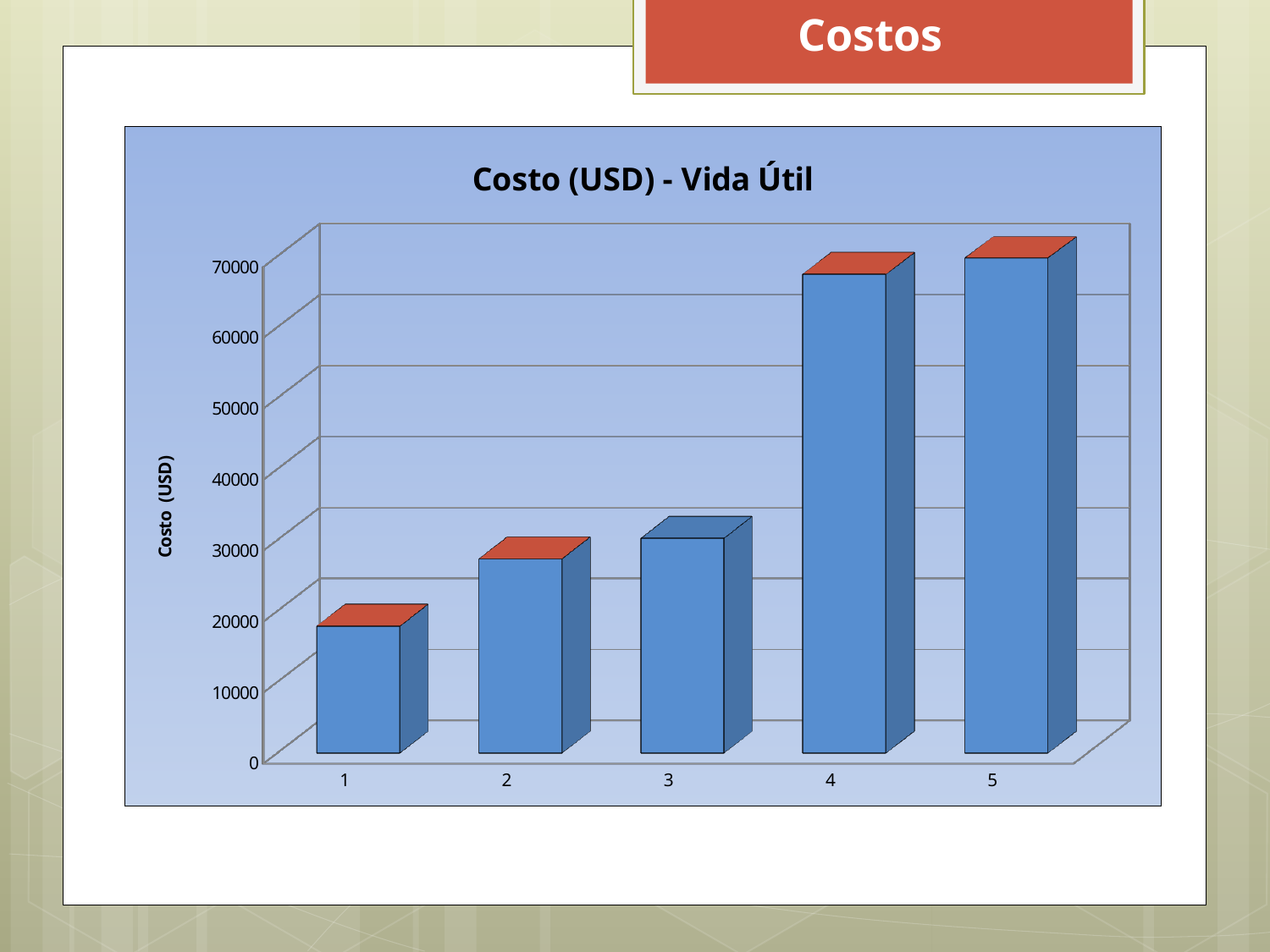
Which category has the lowest cost in the chart? 1 Is the value for category 1 greater or less than 10000? greater What is the title of the chart? Costo (USD) - Vida Útil Which has the larger value, category 2 or category 4? 4 Is the value for category 2 greater or less than 20000? greater Do the values generally rise or fall from category 1 to category 5? Rise Is the value for category 3 greater or less than 40000? less What is the label on the vertical axis of the chart? Costo (USD) What kind of chart is shown on the slide? Bar chart How many bars (categories) are plotted in the chart? 5 Which has the larger value, category 1 or category 3? 3